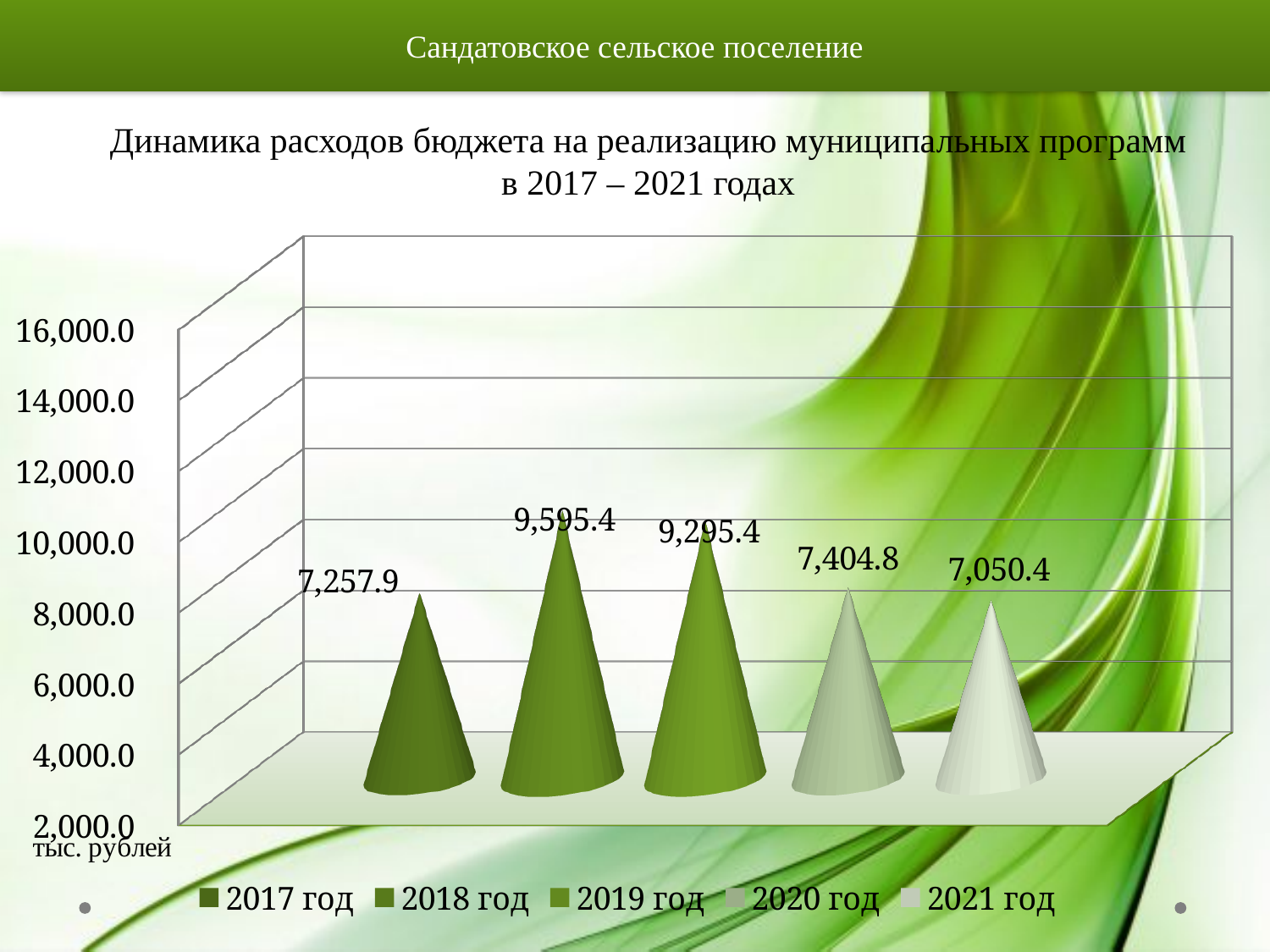
Do the values rise or fall from 2018 год to 2021 год? fall Which year has the lowest value? 2021 год What is the value for 2018 год? 9,595.4 What is the difference between the values for 2017 год and 2021 год? 207.5 What unit is shown below the vertical axis? тыс. рублей How many series does the legend list? 5 Which is larger, the value for 2017 год or the value for 2020 год? 2020 год What is the value for 2017 год? 7,257.9 Which year has the highest value? 2018 год Is the value for 2019 год greater or less than 8,000.0? greater What is the difference between the values for 2018 год and 2019 год? 300.0 What is the value for 2021 год? 7,050.4